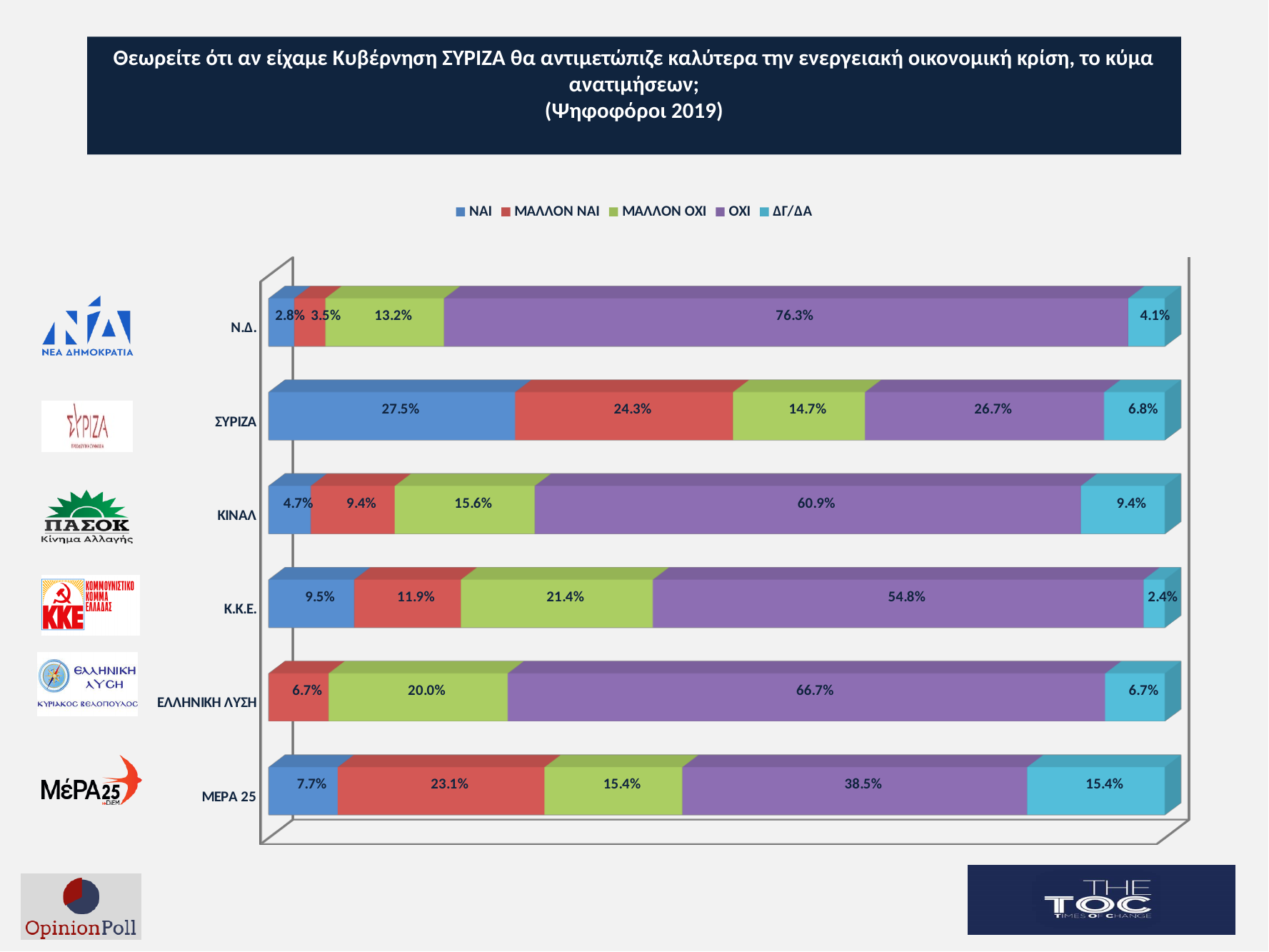
What is the ΝΑΙ value for ΣΥΡΙΖΑ? 27.5% How many series does the legend list? 5 Which is larger, the ΜΑΛΛΟΝ ΝΑΙ value for ΣΥΡΙΖΑ or for ΜΕΡΑ 25? ΣΥΡΙΖΑ Which party has the highest ΟΧΙ value? Ν.Δ. What type of chart is shown on the slide? Stacked bar chart Which series is shown in purple in the legend? ΟΧΙ Which party has the lowest ΝΑΙ value among those with a ΝΑΙ label? Ν.Δ. What is the ΟΧΙ value for Ν.Δ.? 76.3% How many party categories are shown on the chart? 6 What is the ΔΓ/ΔΑ value for ΜΕΡΑ 25? 15.4% What is the difference between the ΟΧΙ values for ΚΙΝΑΛ and Κ.Κ.Ε.? 6.1% What is the ΜΑΛΛΟΝ ΟΧΙ value for Κ.Κ.Ε.? 21.4%